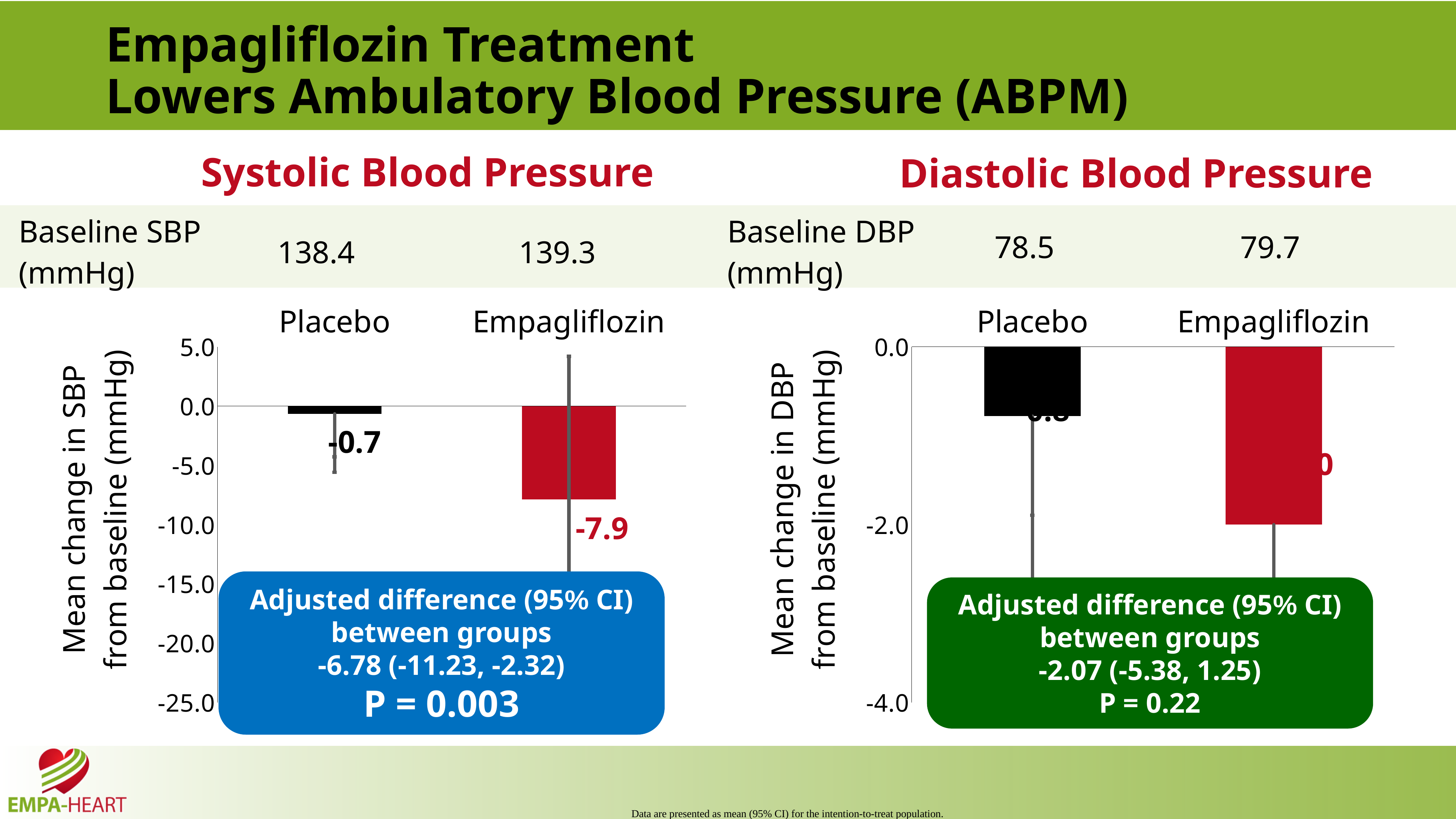
In the Systolic Blood Pressure chart, what is the difference between the Placebo and Empagliflozin mean changes in SBP? 7.2 How many treatment groups are plotted in the Systolic Blood Pressure chart? 2 What is the y-axis label of the Systolic Blood Pressure chart? Mean change in SBP from baseline (mmHg) What P value is shown in the box on the Systolic Blood Pressure chart? P = 0.003 What kind of chart is the Diastolic Blood Pressure chart? bar chart In the Diastolic Blood Pressure chart, which group has the lower (more negative) mean change in DBP from baseline? Empagliflozin In the Diastolic Blood Pressure chart, is the value for Placebo greater or less than -2.0? greater In the Systolic Blood Pressure chart, is the value for Placebo greater or less than -5.0? greater In the Systolic Blood Pressure chart, what is the mean change in SBP from baseline for Placebo? -0.7 In the Systolic Blood Pressure chart, is the value for Empagliflozin greater or less than -5.0? less In the Systolic Blood Pressure chart, which group shows the larger reduction in SBP from baseline? Empagliflozin In the Systolic Blood Pressure chart, what is the mean change in SBP from baseline for Empagliflozin? -7.9